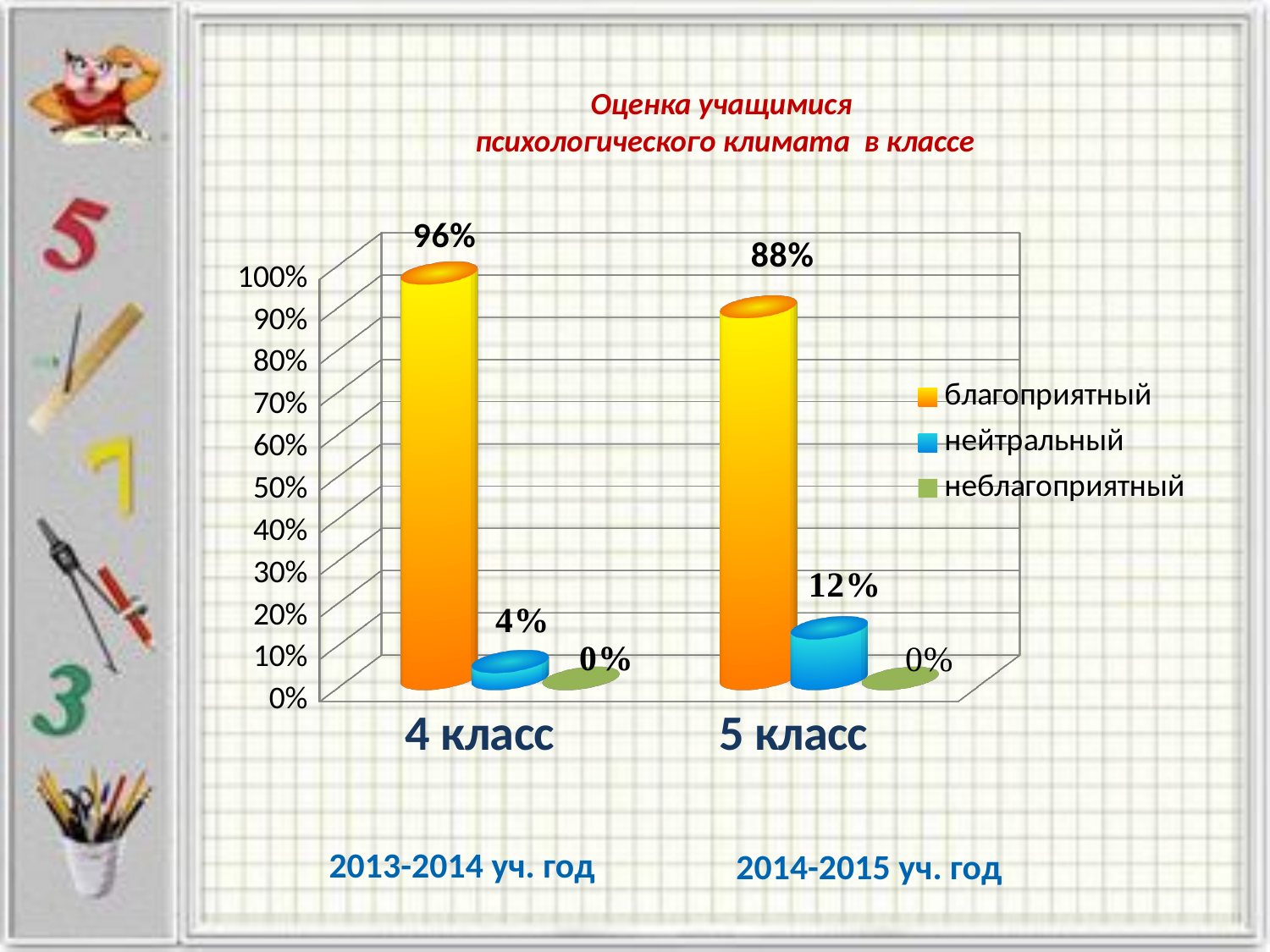
What is the difference between the благоприятный values for 4 класс and 5 класс? 8% What is the value for благоприятный in 5 класс? 88% Which is larger: нейтральный in 4 класс or нейтральный in 5 класс? 5 класс What is the value for благоприятный in 4 класс? 96% How many series does the legend list? 3 How many categories are shown on the x axis? 2 What kind of chart is shown on the slide? bar chart What is the value for неблагоприятный in 4 класс? 0% Does the благоприятный value rise or fall from 4 класс to 5 класс? fall What is the value for нейтральный in 5 класс? 12% Which category has the highest value for благоприятный? 4 класс What is the difference between the нейтральный values for 5 класс and 4 класс? 8%